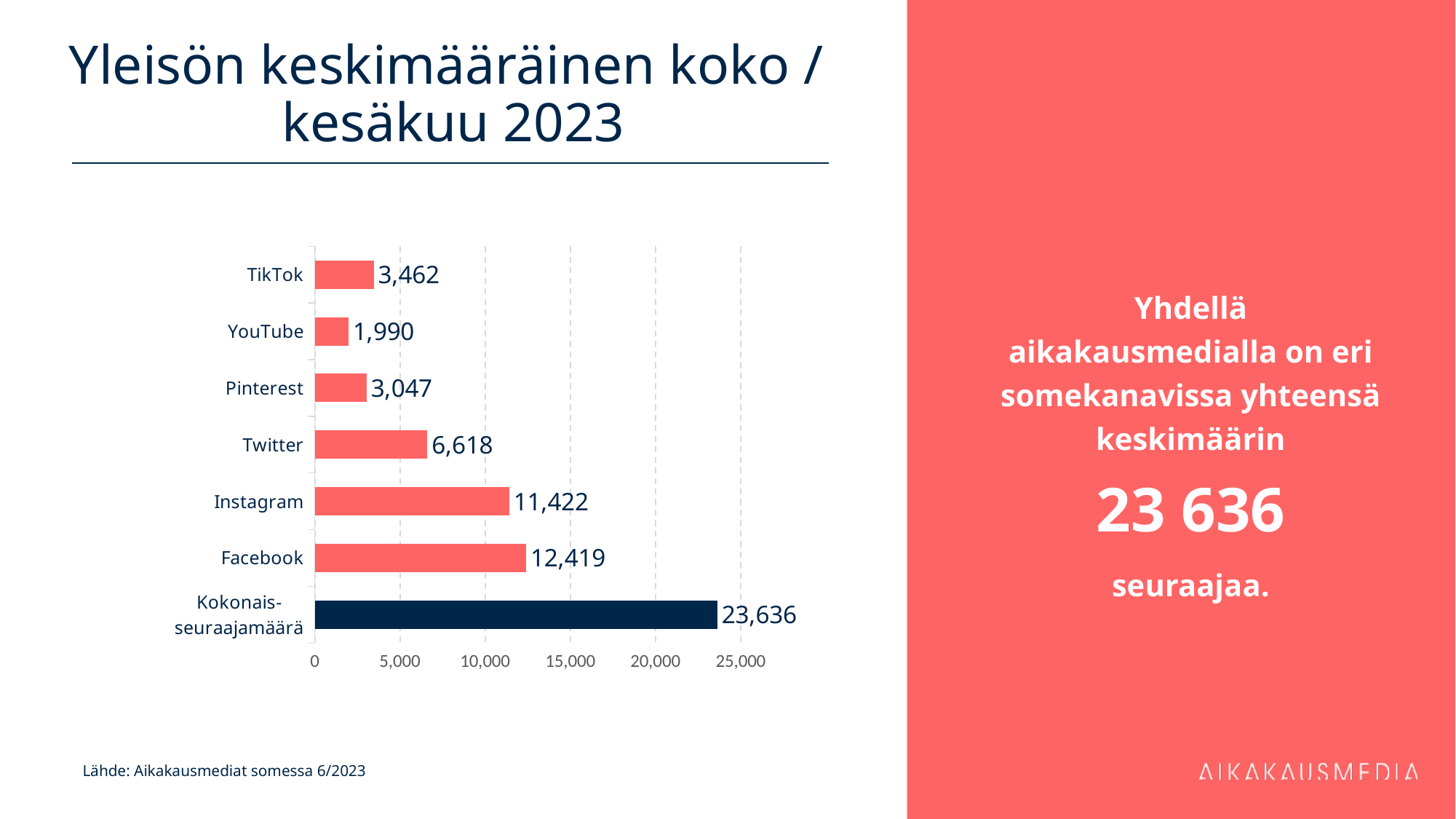
How many categories are shown in the chart? 7 Which category has the lowest value? YouTube What kind of chart is shown on the slide? Bar chart What is the difference between the values for Facebook and Instagram? 997 Which is larger, the value for Twitter or the value for TikTok? Twitter What is the value for Instagram? 11,422 What is the value for Kokonais-seuraajamäärä? 23,636 Which individual social media channel has the highest value? Facebook Is the value for Twitter greater or less than 5,000? greater What is the value for Facebook? 12,419 What is the value for YouTube? 1,990 What is the difference between the values for TikTok and Pinterest? 415